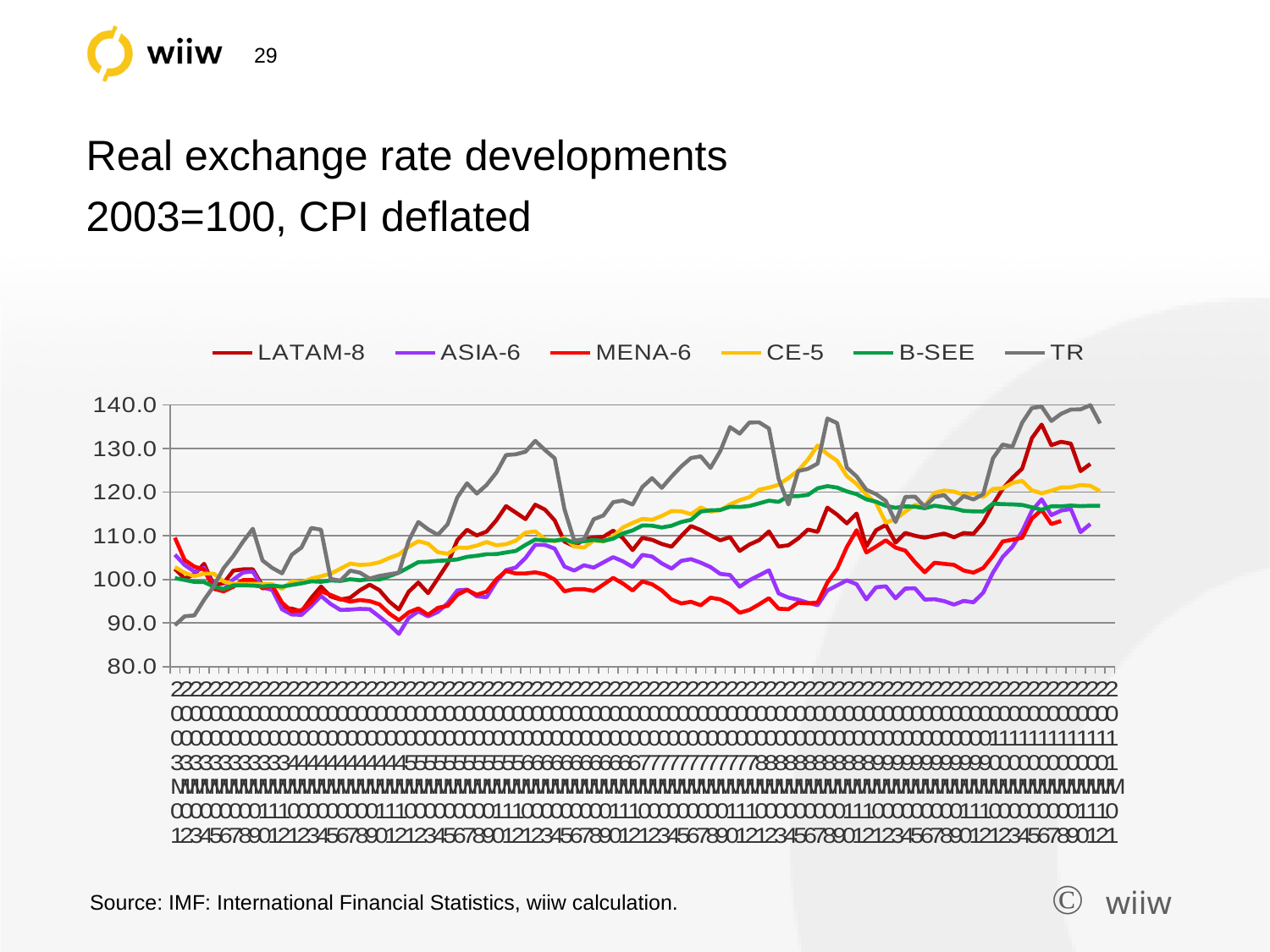
Is the lowest value of ASIA-6 greater or less than 90? less Does the B-SEE series rise or fall overall from the start to the end of the period? rise Is the value for B-SEE at the end of the period greater or less than 110? greater Which series is drawn in grey? TR Is the value for MENA-6 at the end of the period greater or less than 100? greater What kind of chart is shown on the slide? line chart What is the highest value shown on the vertical axis? 140.0 What is the title of the chart? Real exchange rate developments 2003=100, CPI deflated Which series reaches the highest value on the chart? TR How many series does the legend list? 6